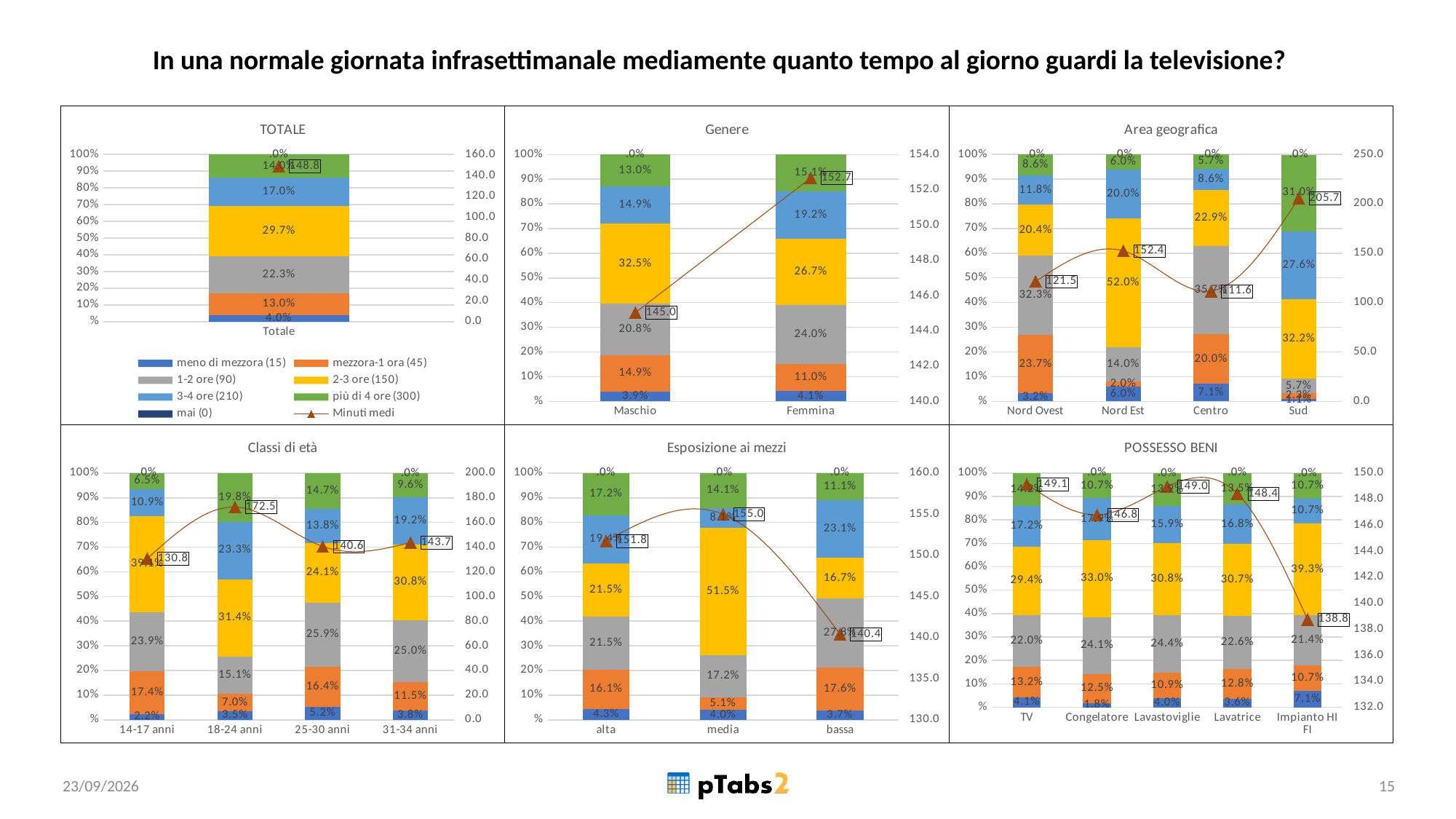
In the TOTALE chart, what is the 'Minuti medi' value for Totale? 148.8 In the Area geografica chart, which area has the highest 'Minuti medi' value? Sud In the Esposizione ai mezzi chart, what is the 'Minuti medi' value for bassa? 140.4 In the TOTALE chart, what is the value for the '2-3 ore (150)' segment? 29.7% In the Classi di età chart, what is the difference in 'Minuti medi' between 18-24 anni and 14-17 anni? 41.7 In the Genere chart, what is the 'Minuti medi' value for Femmina? 152.7 In the Genere chart, which has the larger '2-3 ore (150)' share, Maschio or Femmina? Maschio How many entries does the legend in the TOTALE chart list? 8 In the Classi di età chart, how many age categories are shown on the x axis? 4 In the Area geografica chart, which area has the lowest 'Minuti medi' value? Centro In the Area geografica chart, what is the '2-3 ore (150)' share for Nord Est? 52.0% In the POSSESSO BENI chart, what is the '2-3 ore (150)' share for Impianto HI FI? 39.3%